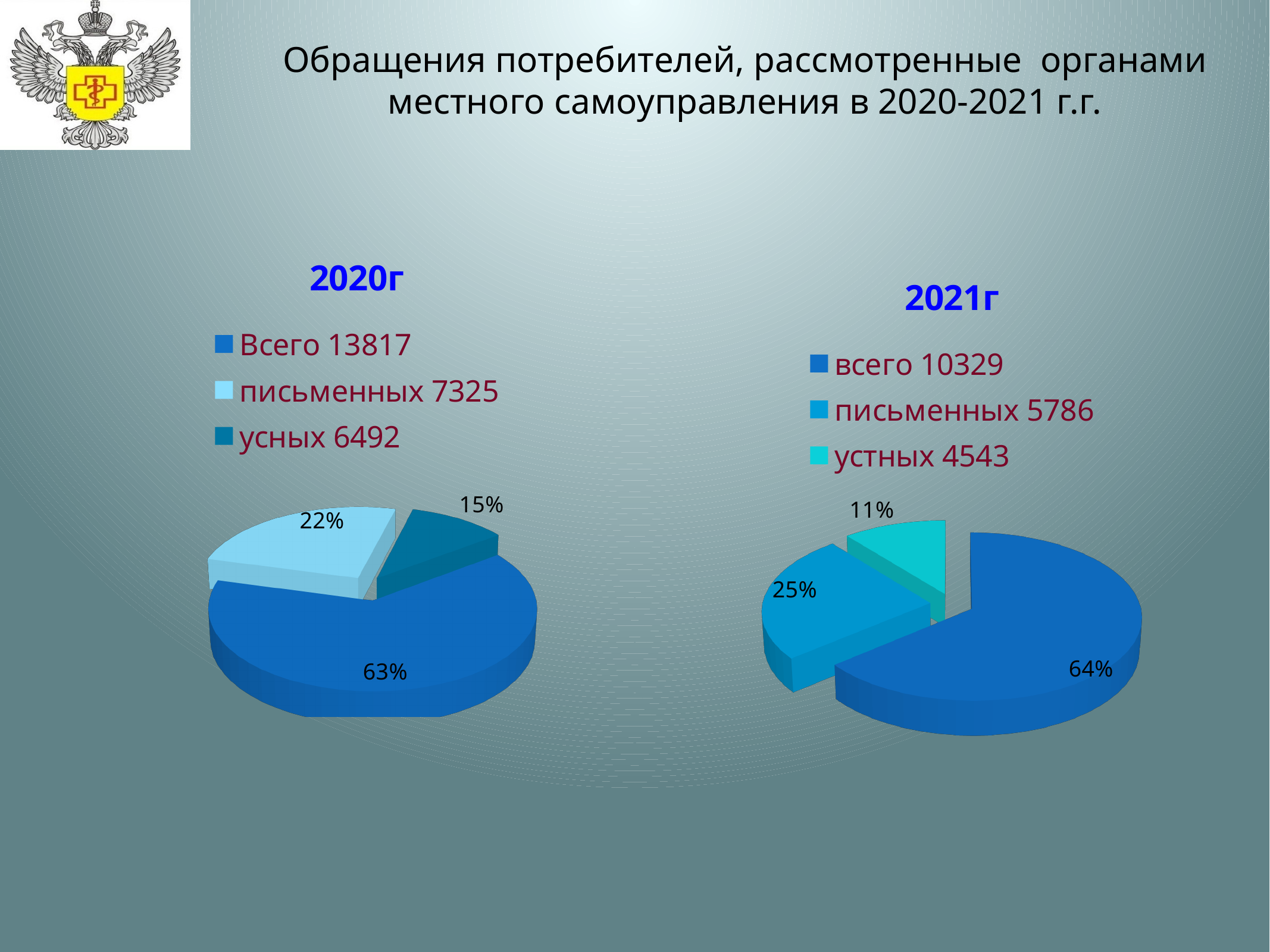
In the "2020г" chart, what percentage is shown for the "Всего 13817" slice? 63% In the "2021г" chart, what percentage is shown for the "всего 10329" slice? 64% How many slices does the "2021г" pie chart have? 3 In the "2021г" chart, which slice is the smallest? устных 4543 In the "2020г" chart, what percentage is shown for the "письменных 7325" slice? 22% In the "2020г" chart, which slice is larger: "письменных 7325" or "усных 6492"? письменных 7325 In the "2021г" chart, what percentage is shown for the "письменных 5786" slice? 25% In the "2020г" chart, what percentage is shown for the "усных 6492" slice? 15% What is the title of the chart on the right side of the slide? 2021г What kind of chart is the "2020г" chart? pie chart In the "2021г" chart, what percentage is shown for the "устных 4543" slice? 11% In the "2020г" chart, which slice is the largest? Всего 13817